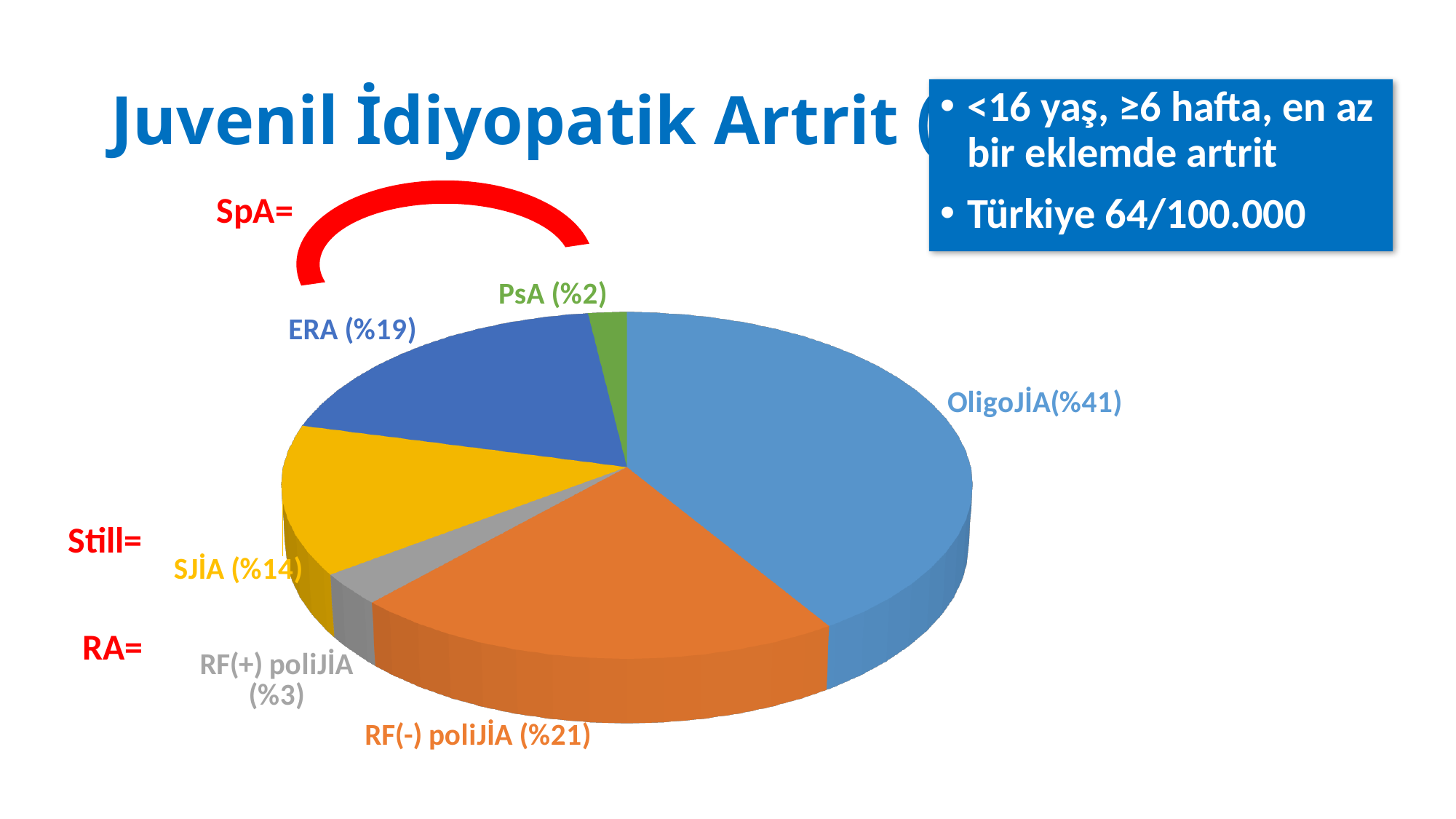
What share of the pie is labelled for PsA? %2 What share of the pie is labelled for ERA? %19 What share of the pie is labelled for RF(-) poliJİA? %21 Which is larger, the ERA slice or the SJİA slice? ERA What kind of chart is shown on the slide? pie chart What share of the pie is labelled for OligoJİA? %41 How many slices does the pie chart have? 6 Which category has the smallest slice of the pie? PsA Which category has the largest slice of the pie? OligoJİA What colour is the OligoJİA slice? blue What share of the pie is labelled for SJİA? %14 What is the difference in percentage points between OligoJİA and RF(-) poliJİA? 20